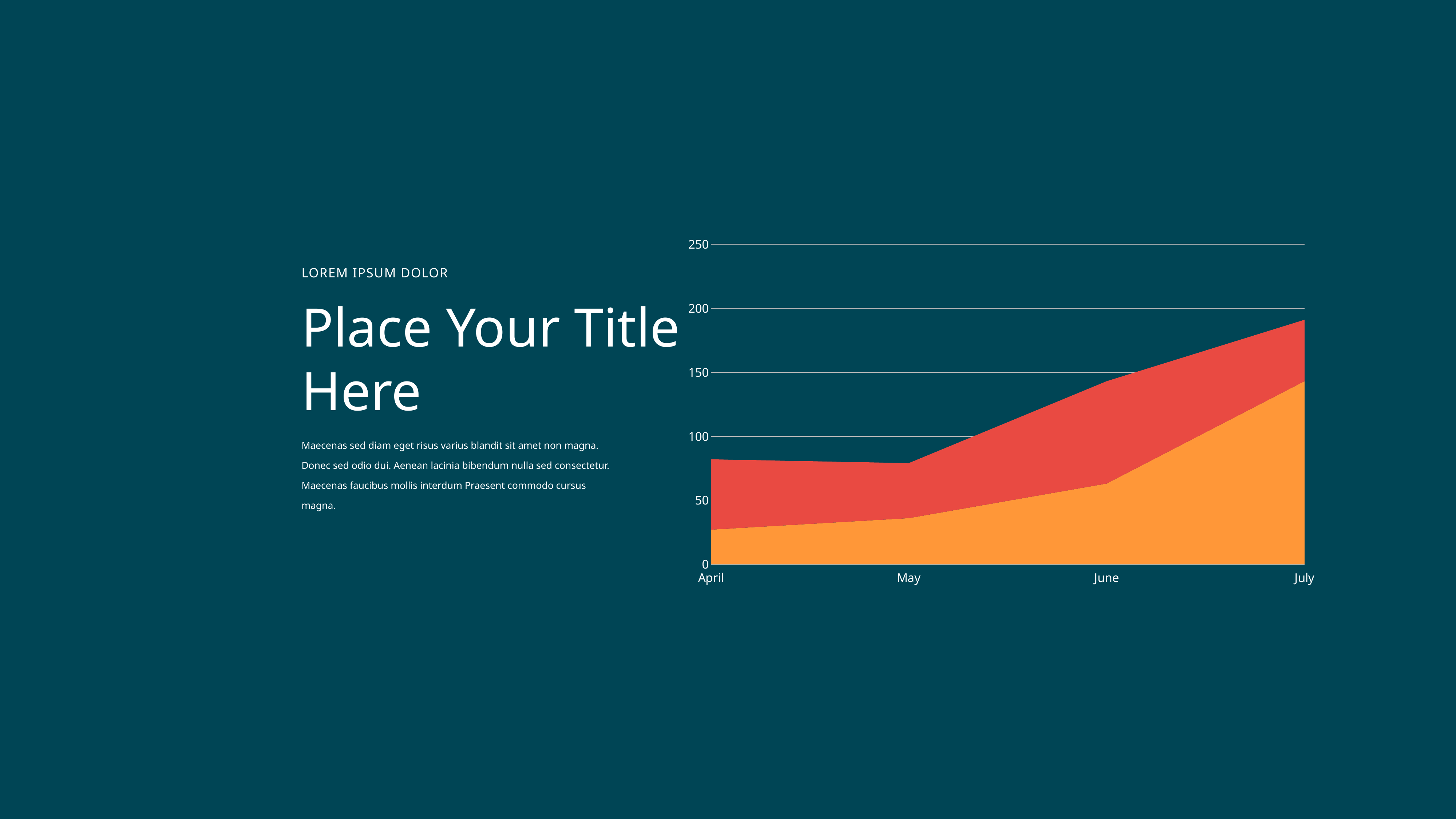
Does the orange series rise or fall from April to July? rise Is the total (top of the stacked area) for July greater or less than 150? greater Is the total (top of the stacked area) for June greater or less than 100? greater Which month has the highest total (top of the stacked area)? July How many series are plotted in the stacked area chart? 2 What is the highest value shown on the y axis of the chart? 250 Is the total (top of the stacked area) for April greater or less than 100? less How many months are shown on the x axis of the chart? 4 Which is larger, the total for June or the total for April? June What kind of chart is shown on the slide? area chart